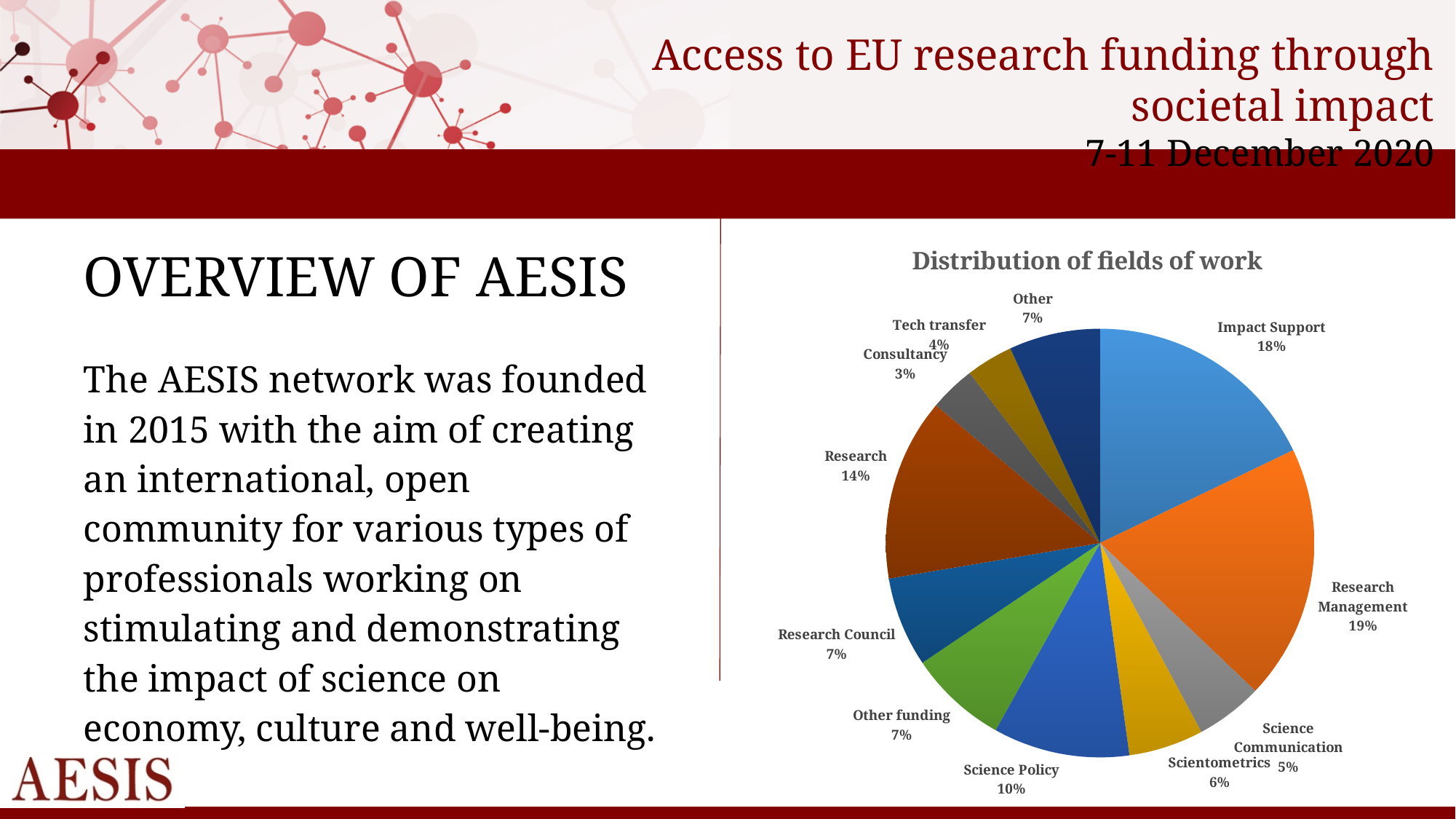
What is the combined share of Tech transfer and Other? 11% What share of the pie does Research Management represent? 19% What percentage is shown for Consultancy? 3% How many slices does the pie chart have? 11 What percentage is shown for Science Policy? 10% What is the difference in percentage points between Research and Research Council? 7 Which is larger, the share for Scientometrics or the share for Science Communication? Scientometrics What kind of chart is shown on the slide? Pie chart What is the title of the chart? Distribution of fields of work Which field of work has the smallest share of the pie? Consultancy What percentage is shown for Impact Support? 18% Which field of work has the largest share of the pie? Research Management